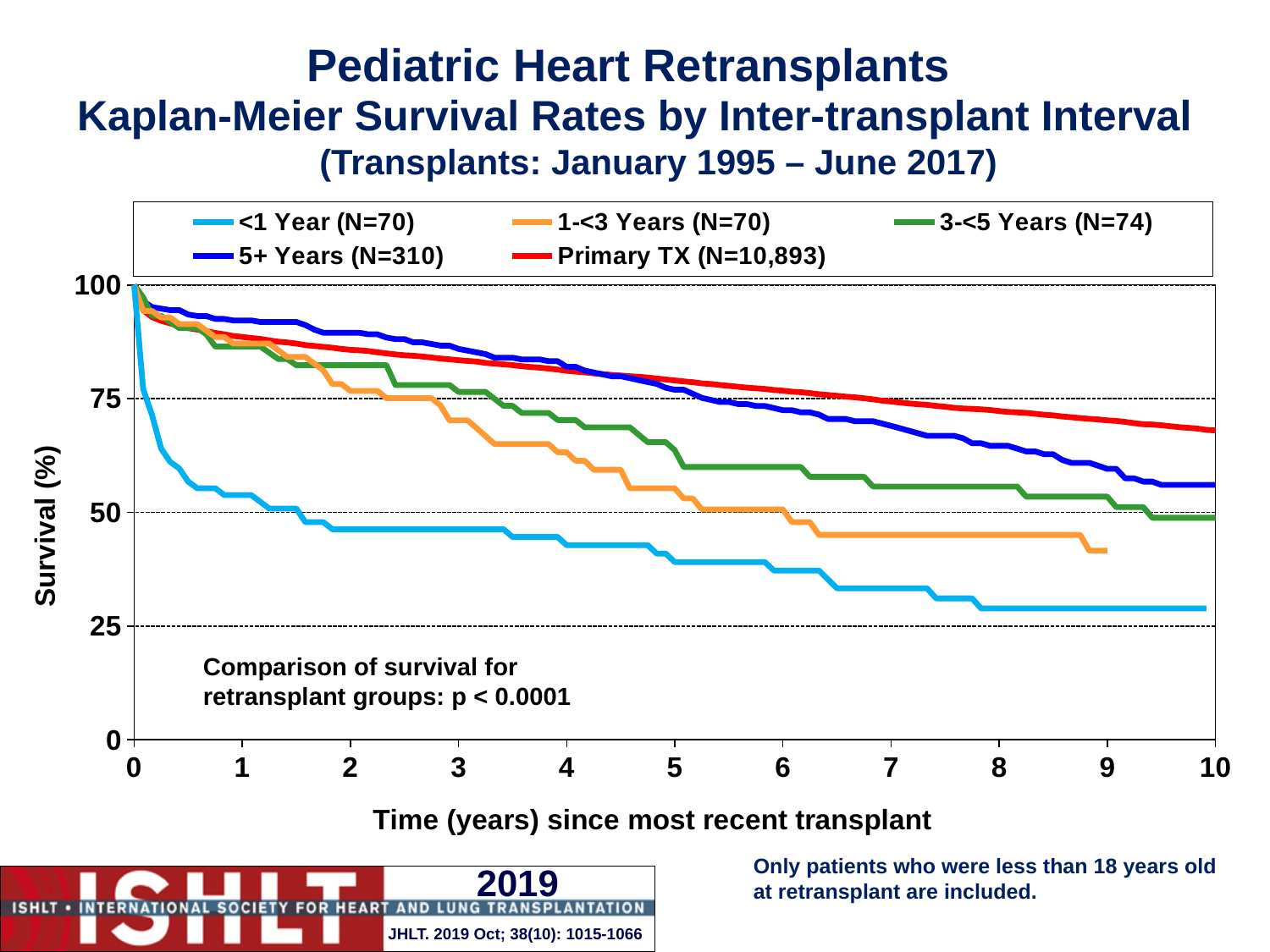
What p-value is stated for the comparison of survival for retransplant groups? p < 0.0001 Is the survival for the Primary TX group at 10 years greater or less than 50%? greater At 8 years, which has higher survival: the <1 Year group or the 1-<3 Years group? 1-<3 Years Is the survival for the 1-<3 Years group at 9 years greater or less than 50%? less Is the survival for the <1 Year group at 10 years greater or less than 50%? less Which series has the highest survival at 10 years? Primary TX (N=10,893) What is the N for the Primary TX series in the legend? 10,893 How many series does the legend list? 5 Which series has the lowest survival curve across the whole time range? <1 Year (N=70) Do the survival curves rise or fall as time since transplant increases? fall What kind of chart is shown on the slide? line chart